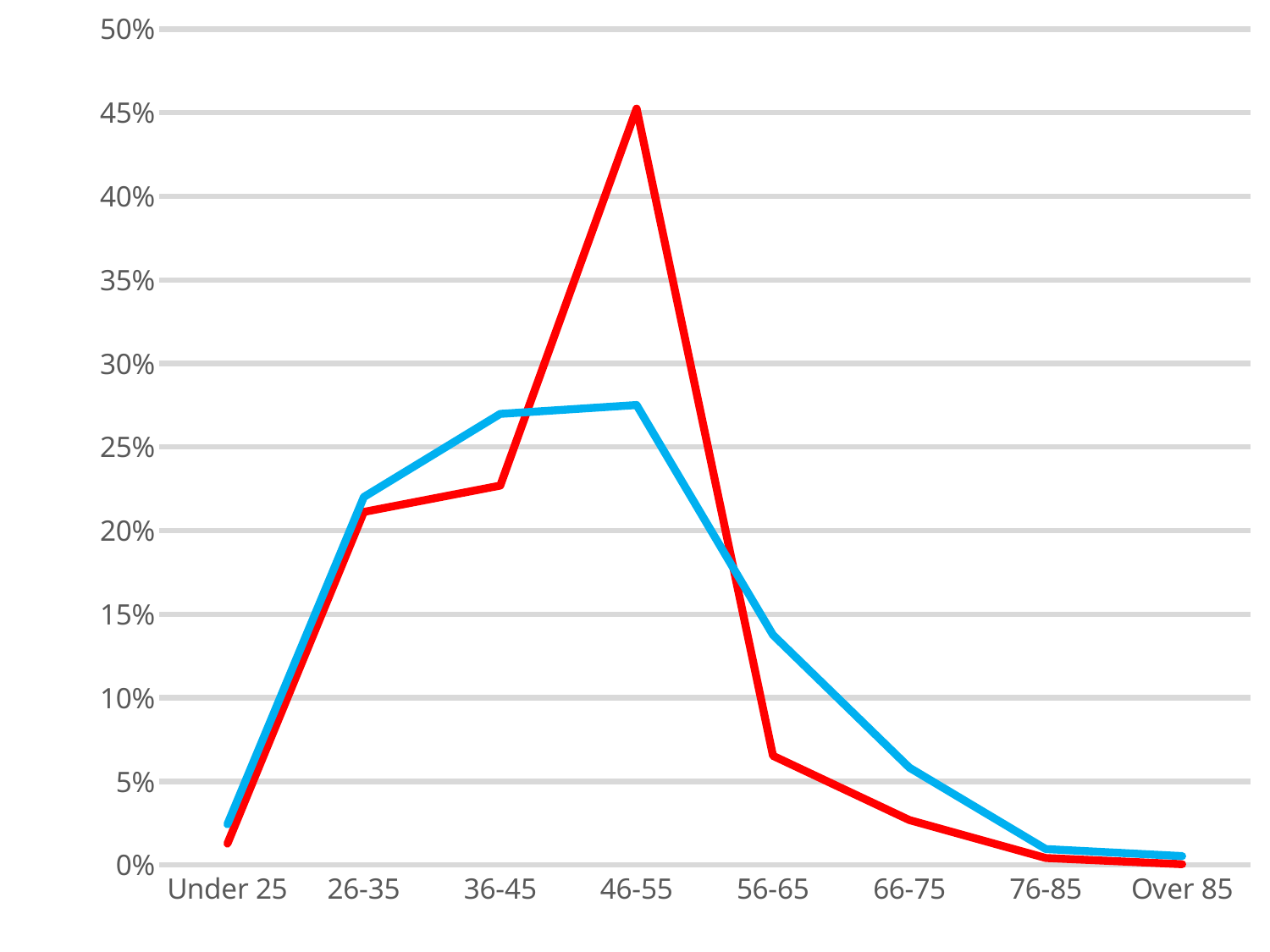
Is the value of the red line for 46-55 greater or less than 40%? greater What kind of chart is shown on the slide? line chart How many age categories are shown on the x axis? 8 At 36-45, which line has the higher value, the red line or the blue line? the blue line Is the value of the blue line for 56-65 greater or less than 10%? greater Is the value of the blue line for 46-55 greater or less than 30%? less What is the highest value shown on the y axis? 50% How many lines are plotted on the chart? 2 At 46-55, which line has the higher value, the red line or the blue line? the red line Does the red line rise or fall from 46-55 to Over 85? fall In which age category does the red line reach its highest value? 46-55